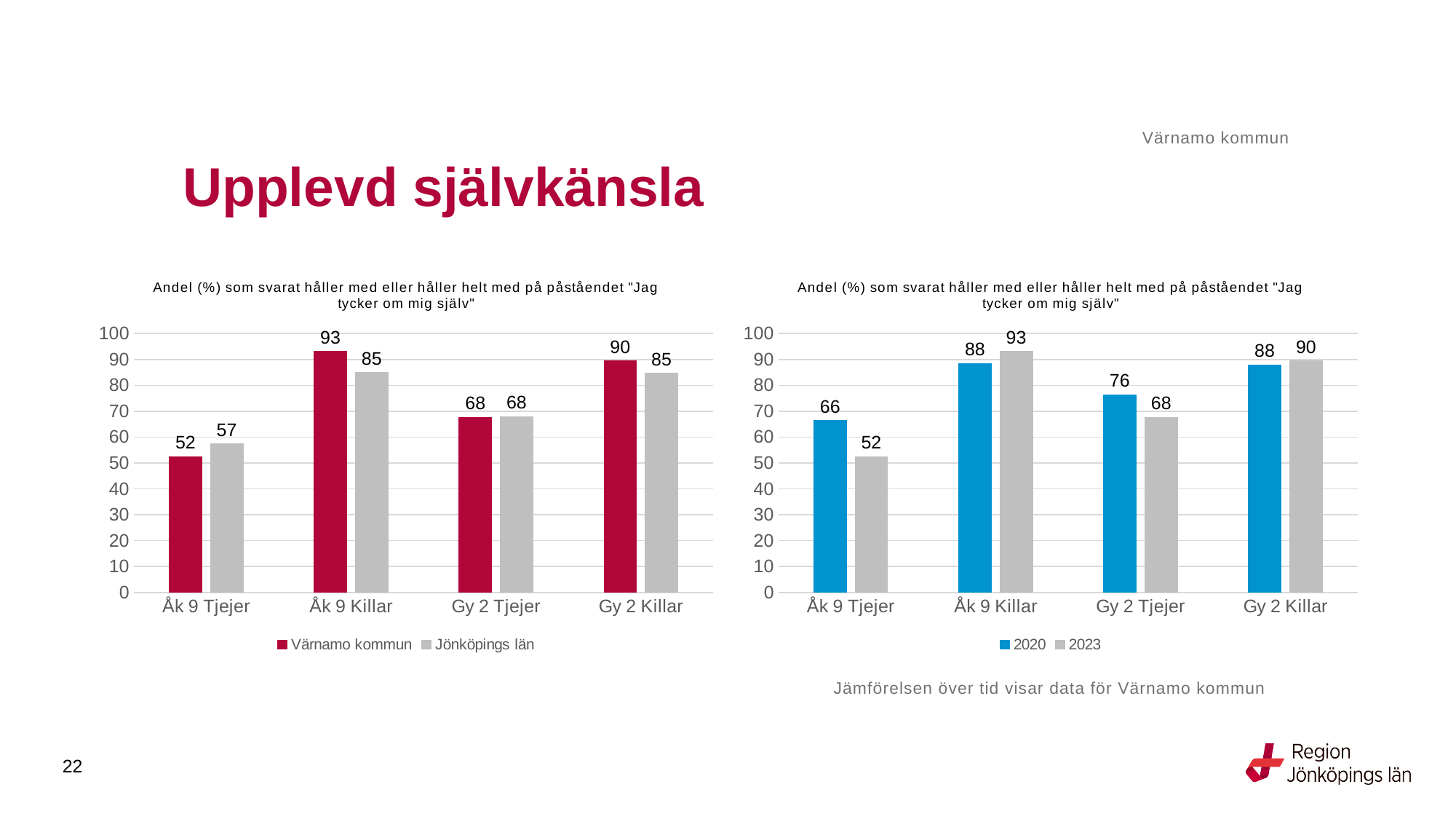
In the right chart, what is the difference between 2020 and 2023 for Åk 9 Tjejer? 14 In the left chart, what is the value for Jönköpings län for Åk 9 Tjejer? 57 In the right chart, which is larger for Gy 2 Tjejer: 2020 or 2023? 2020 In the left chart, which category has the lowest value for Värnamo kommun? Åk 9 Tjejer In the right chart, what is the value for 2023 for Åk 9 Tjejer? 52 In the right chart, which category has the highest value for 2023? Åk 9 Killar How many series does the legend of the right chart list? 2 In the left chart, what is the value for Värnamo kommun for Åk 9 Killar? 93 In the left chart, what is the difference between Värnamo kommun and Jönköpings län for Åk 9 Killar? 8 In the right chart, what is the value for 2020 for Gy 2 Tjejer? 76 What type of chart is the left chart? Bar chart How many categories are shown on the x axis of the left chart? 4